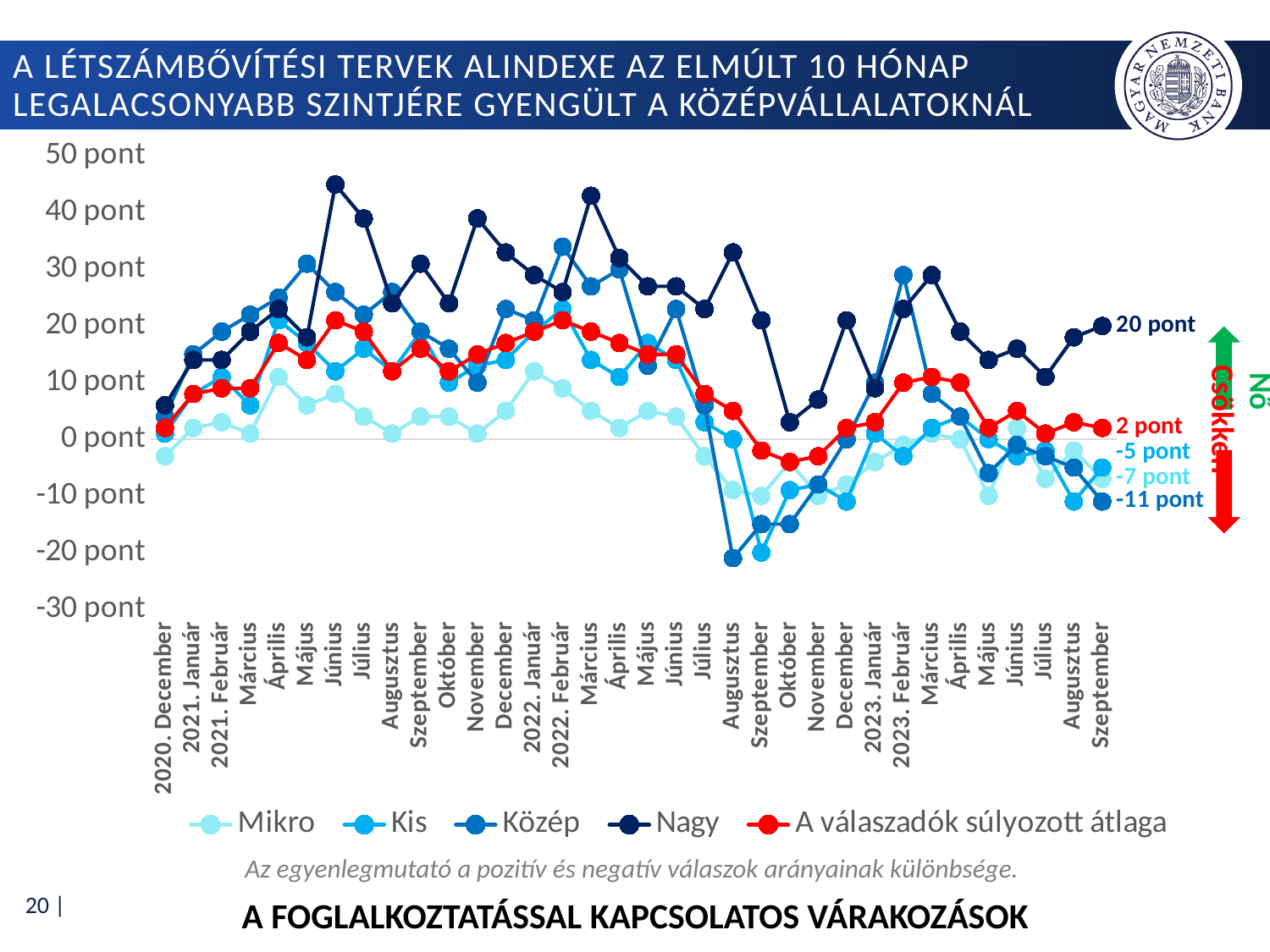
How many series does the legend list? 5 What is the value of the Mikro series in 2023 Szeptember? -7 pont What is the value of 'A válaszadók súlyozott átlaga' in 2023 Szeptember? 2 pont Is the value of the Közép series in 2022 Augusztus greater or less than -10 pont? less What is the value of the Kis series in 2023 Szeptember? -5 pont Is the value of the Nagy series in 2021 Június greater or less than 40 pont? greater Which series has the lowest value in 2023 Szeptember? Közép What is the value of the Nagy series in 2023 Szeptember? 20 pont Which series has the highest value in 2023 Szeptember? Nagy What is the value of the Közép series in 2023 Szeptember? -11 pont What kind of chart is shown on the slide? line chart What is the difference between the Nagy and Közép values in 2023 Szeptember? 31 pont